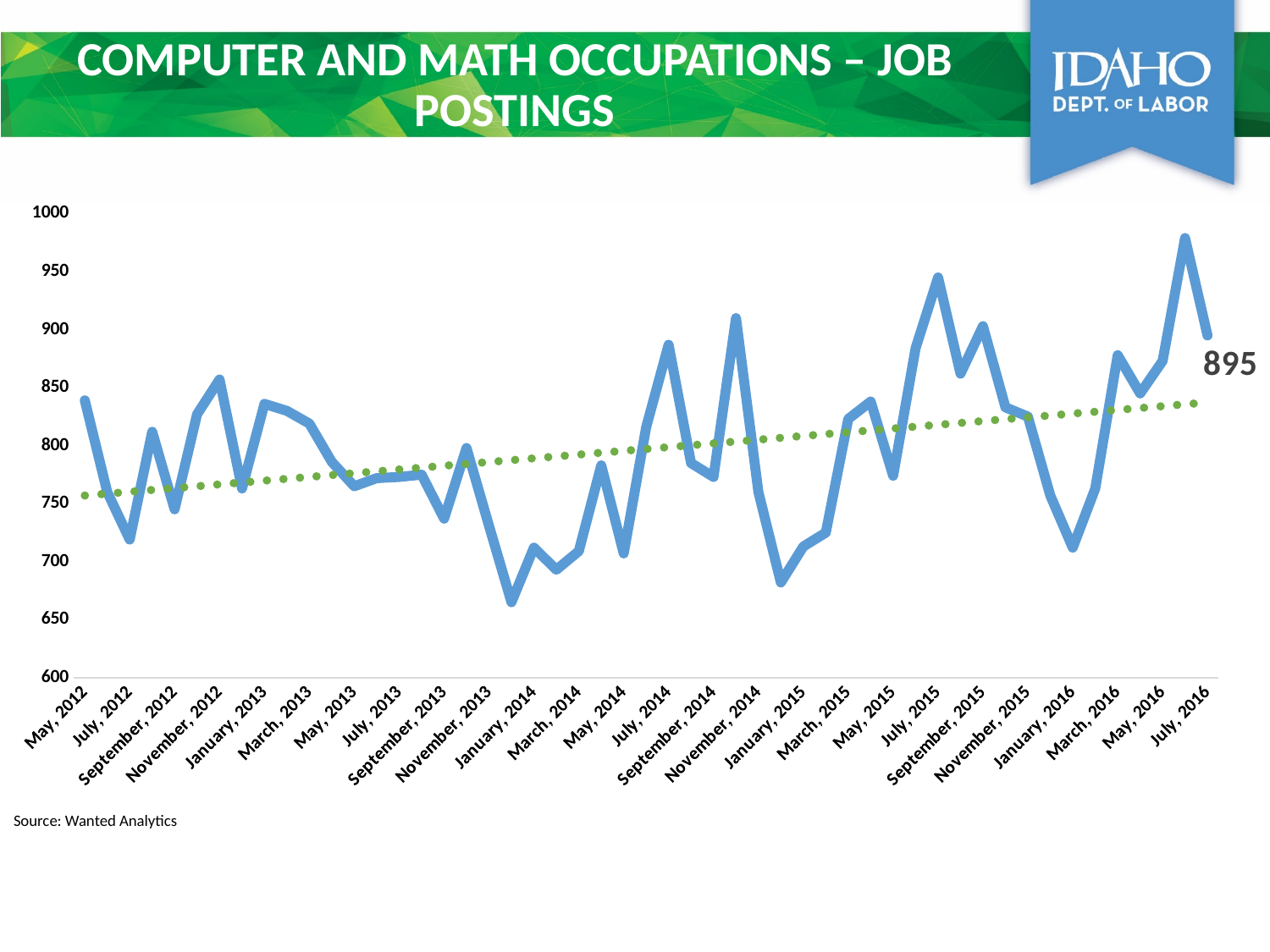
Is the value for January, 2015 greater or less than 700? greater Is the value for January, 2014 greater or less than 700? greater What source is cited for the chart data? Wanted Analytics Which is higher, the value for May, 2016 or July, 2016? July, 2016 What kind of chart is shown on the slide? line chart Is the value for May, 2016 greater or less than 950? less What is the title of the chart? Computer and Math Occupations – Job Postings Which month has the highest number of job postings? June, 2016 Does the dotted trend line rise or fall from May 2012 to July 2016? rise What is the value of the last data point, July 2016? 895